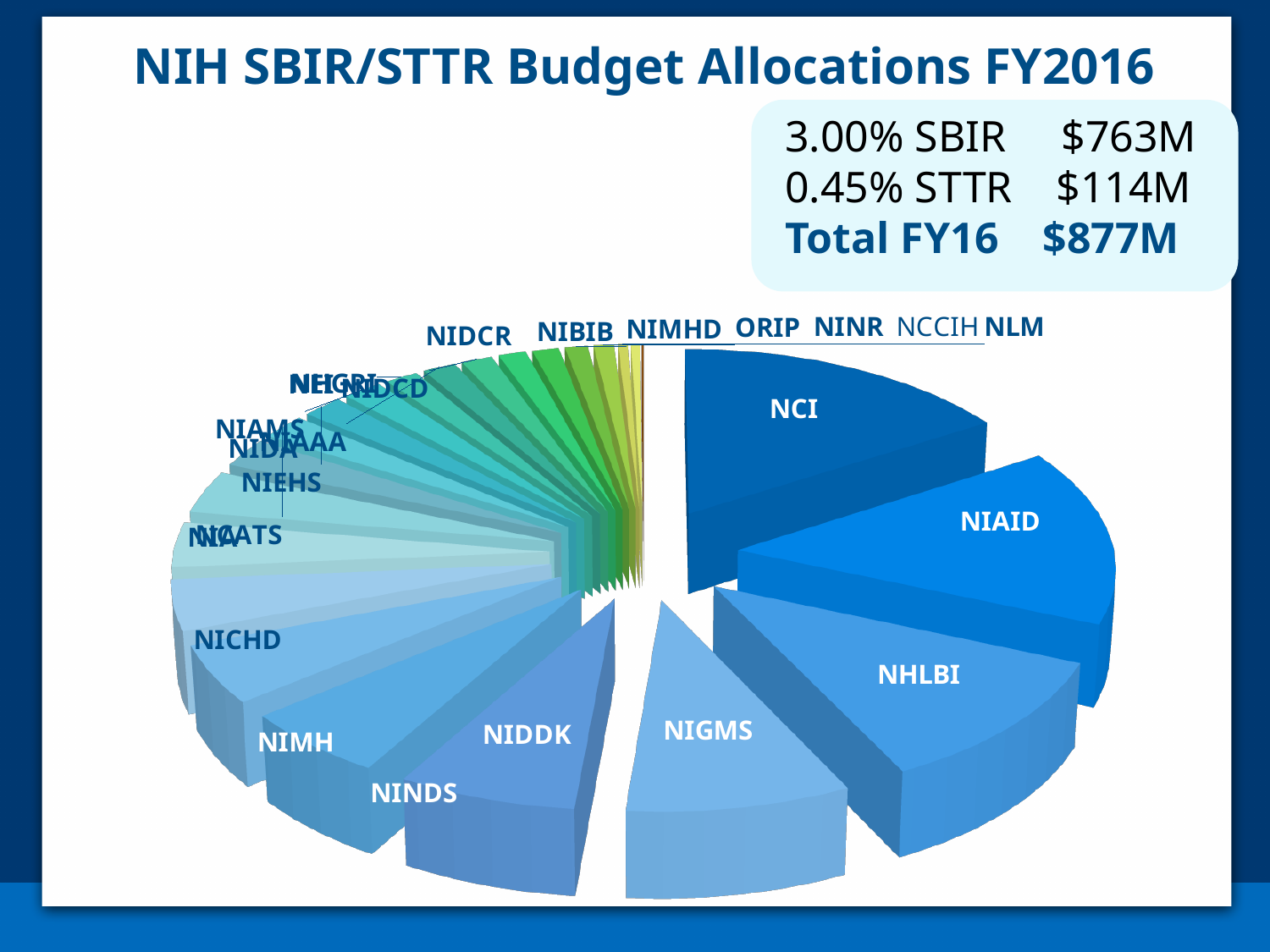
Which slice is larger, NCI or NIGMS? NCI Which slice is larger, NHLBI or NIDCR? NHLBI Which slice is larger, NIGMS or NLM? NIGMS What is the title of the chart on the slide? NIH SBIR/STTR Budget Allocations FY2016 Which institute has the largest slice of the pie? NCI What total FY16 amount is shown in the text box above the chart? $877M What kind of chart is shown on the slide? pie chart